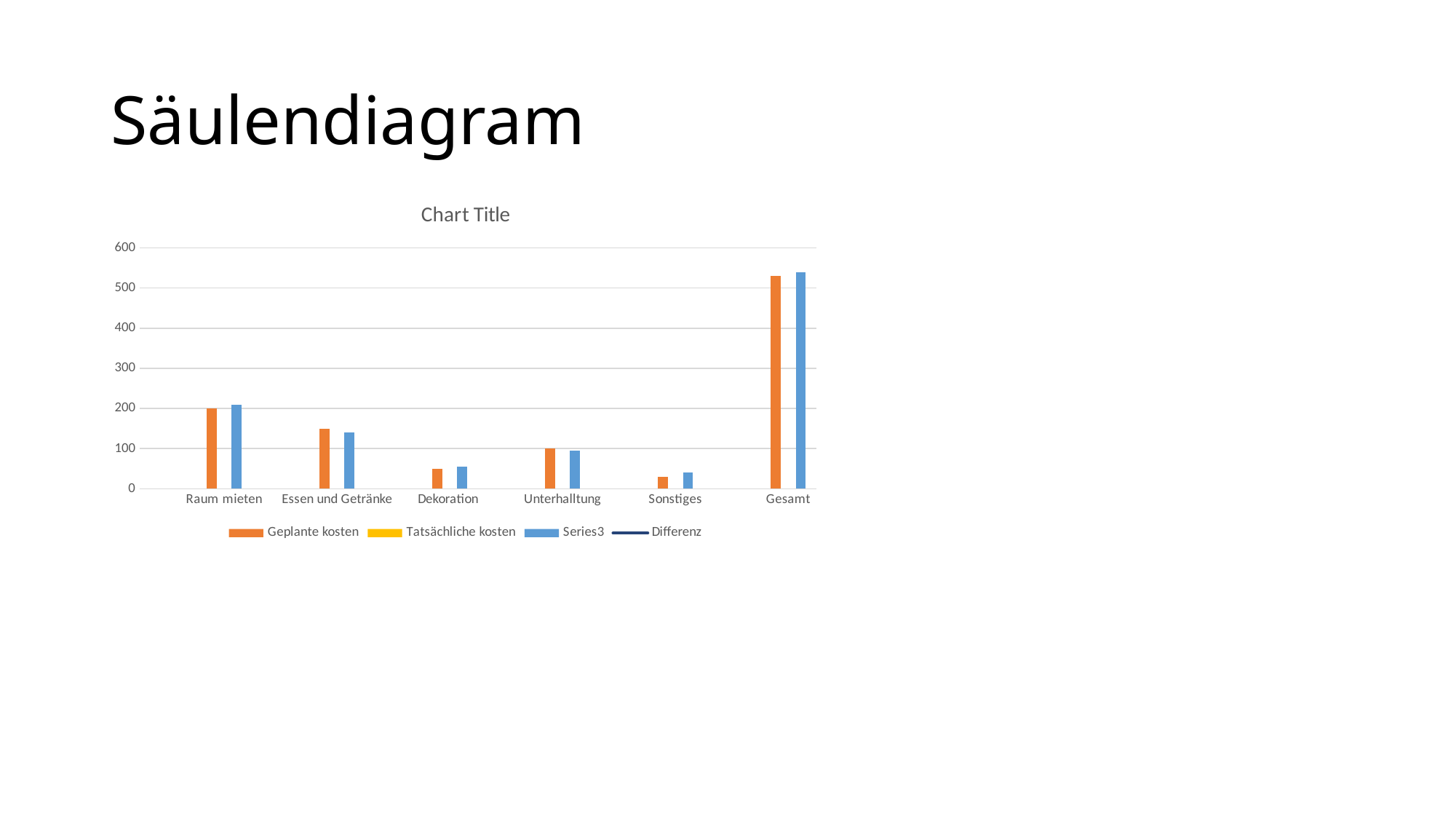
How many categories are shown on the x axis of the chart? 6 Is the value for Geplante kosten for Gesamt greater or less than 500? greater Which category has the highest value for Series3? Gesamt How many series does the chart legend list? 4 Which category has the lowest value for Series3? Sonstiges Which category has the highest value for Geplante kosten? Gesamt What is the title shown above the chart? Chart Title Which is larger for Geplante kosten: Raum mieten or Unterhalltung? Raum mieten Is the value for Series3 for Dekoration greater or less than 100? less Is the value for Geplante kosten for Essen und Getränke greater or less than 100? greater What kind of chart is shown on the slide? bar chart Which category has the lowest value for Geplante kosten? Sonstiges